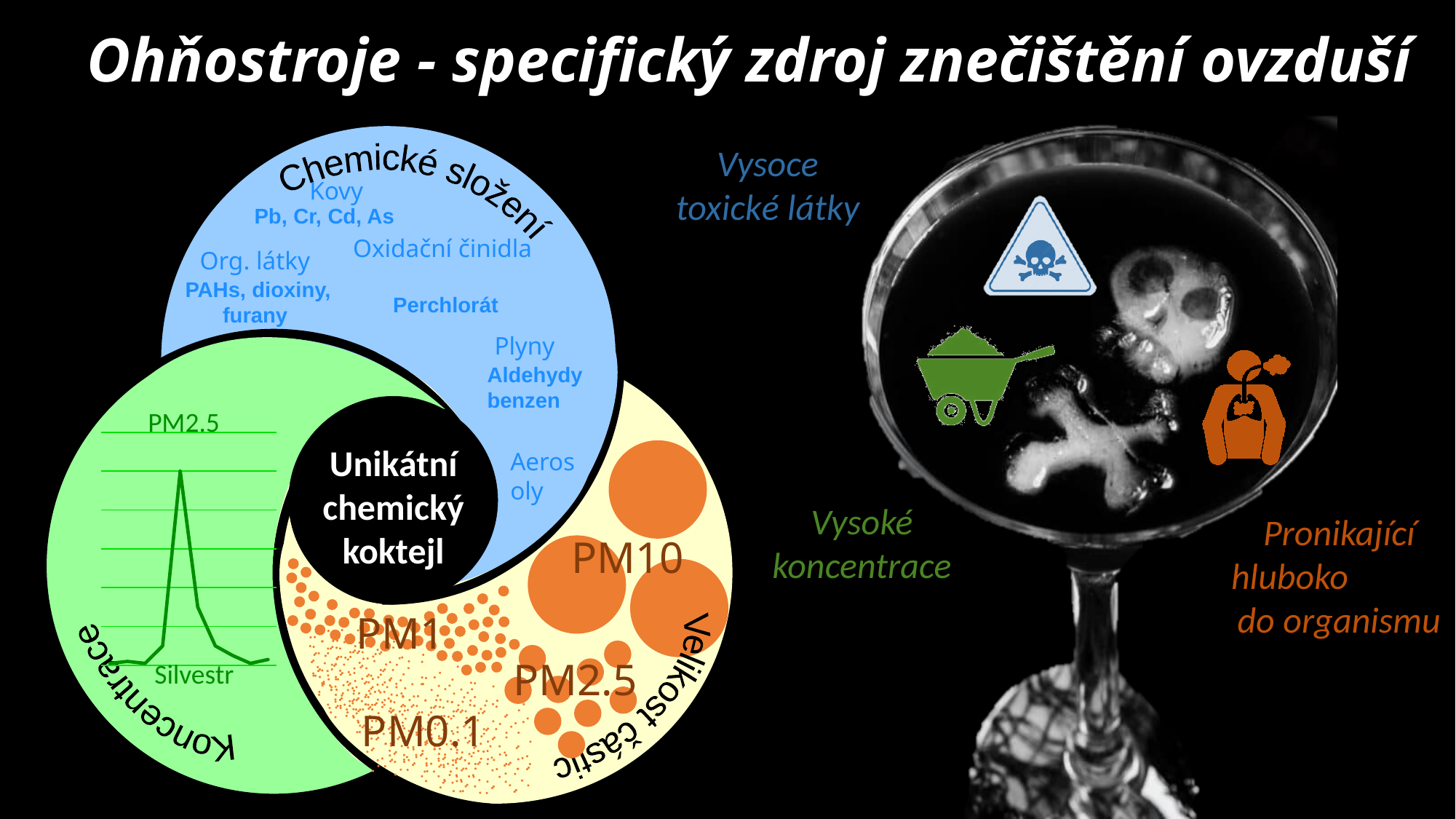
In the line chart inside the green circle, how many lines (series) are plotted? 1 What kind of chart is shown inside the green circle on the left of the slide? line chart In the line chart inside the green circle, after reaching its peak, does the PM2.5 line rise or fall toward the right end of the axis? fall In the line chart inside the green circle, which pollutant does the plotted line represent? PM2.5 In the line chart inside the green circle, what is the label written along the vertical axis? Koncentrace In the line chart inside the green circle, does the PM2.5 line stay flat or show a sharp peak around the point labelled Silvestr? sharp peak